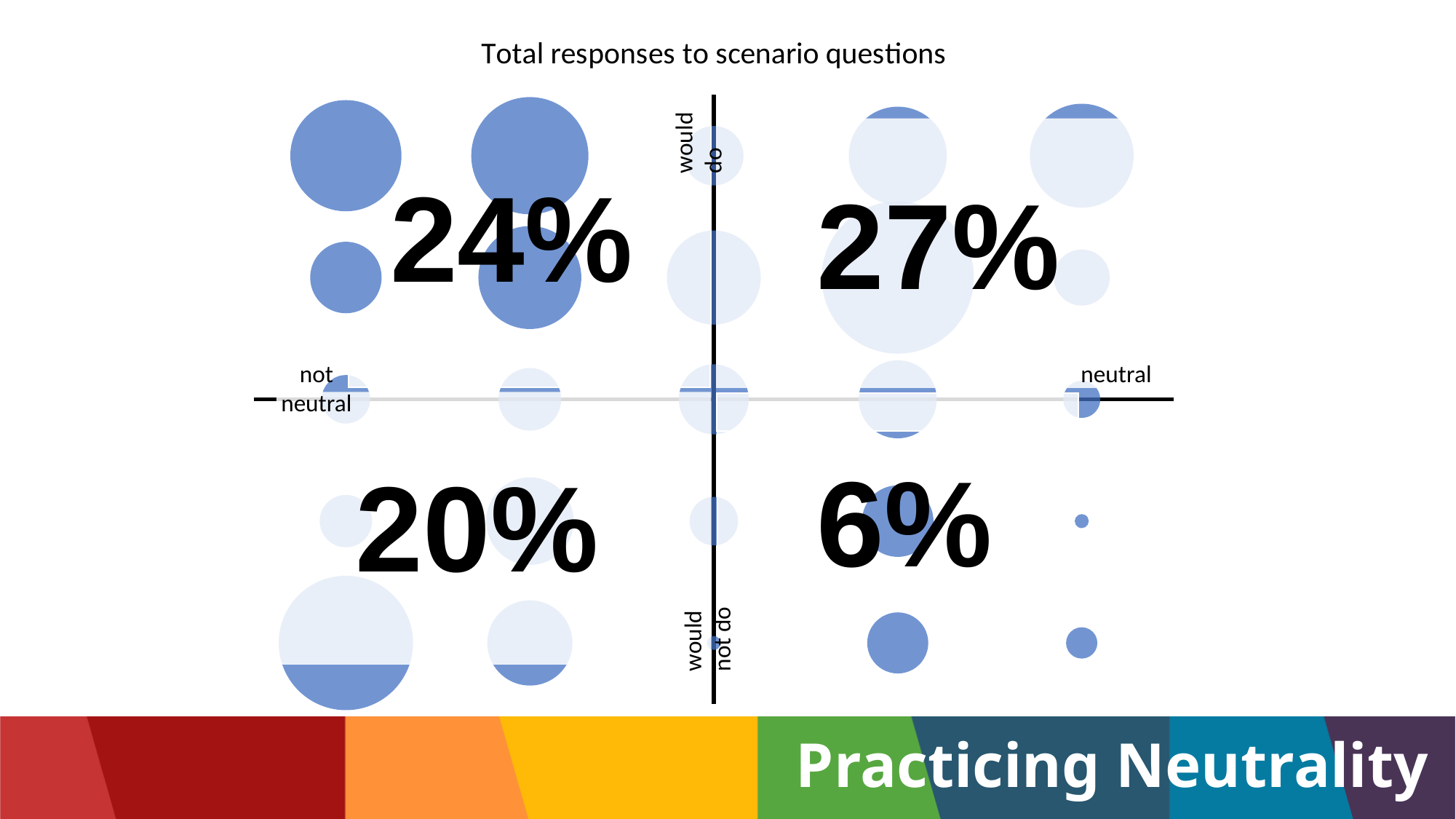
Which is larger, the top-left quadrant percentage or the bottom-left quadrant percentage? Top-left (24%) Which quadrant has the highest percentage? Top-right (neutral, would do), 27% What percentage is shown in the top-left quadrant (not neutral, would do)? 24% What is the difference between the top-right quadrant percentage and the bottom-right quadrant percentage? 21% What percentage is shown in the top-right quadrant (neutral, would do)? 27% Which quadrant has the lowest percentage? Bottom-right (neutral, would not do), 6% What percentage is shown in the bottom-right quadrant (neutral, would not do)? 6% What percentage is shown in the bottom-left quadrant (not neutral, would not do)? 20% What are the labels at the two ends of the horizontal axis? not neutral (left) and neutral (right) What is the title of the chart? Total responses to scenario questions What is the combined percentage of the two 'would do' quadrants (top-left and top-right)? 51% What kind of chart is this? Bubble chart